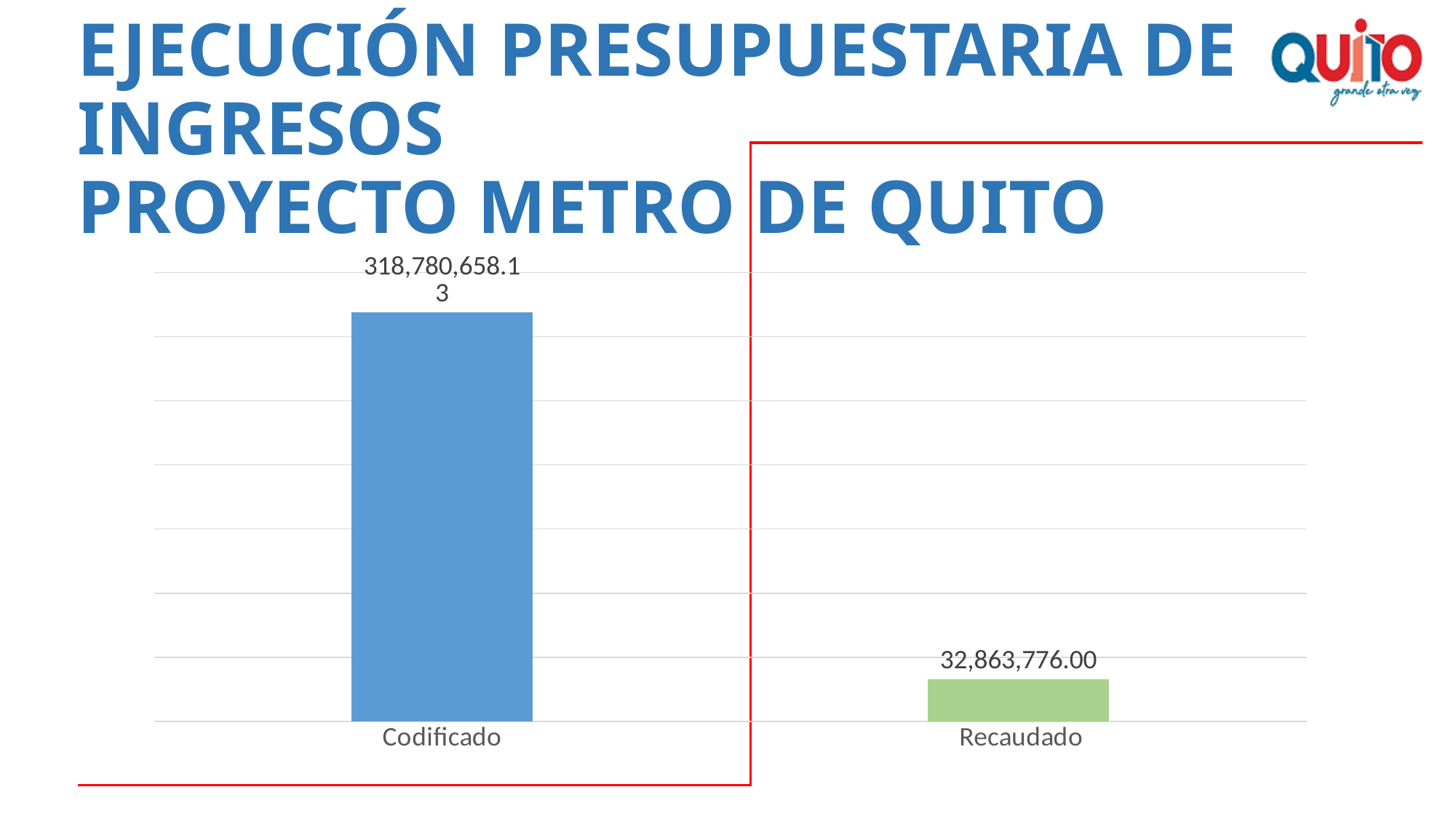
What is the value for Recaudado? 32,863,776.00 What is the value for Codificado? 318,780,658.13 What is the difference between the Codificado and Recaudado values? 285,916,882.13 How many categories are shown in the chart? 2 Which category has the lowest value? Recaudado What colour is the Recaudado bar? Green What colour is the Codificado bar? Blue Which is larger, Codificado or Recaudado? Codificado Which category has the highest value? Codificado What is the combined total of the Codificado and Recaudado values? 351,644,434.13 What kind of chart is shown on the slide? Bar chart